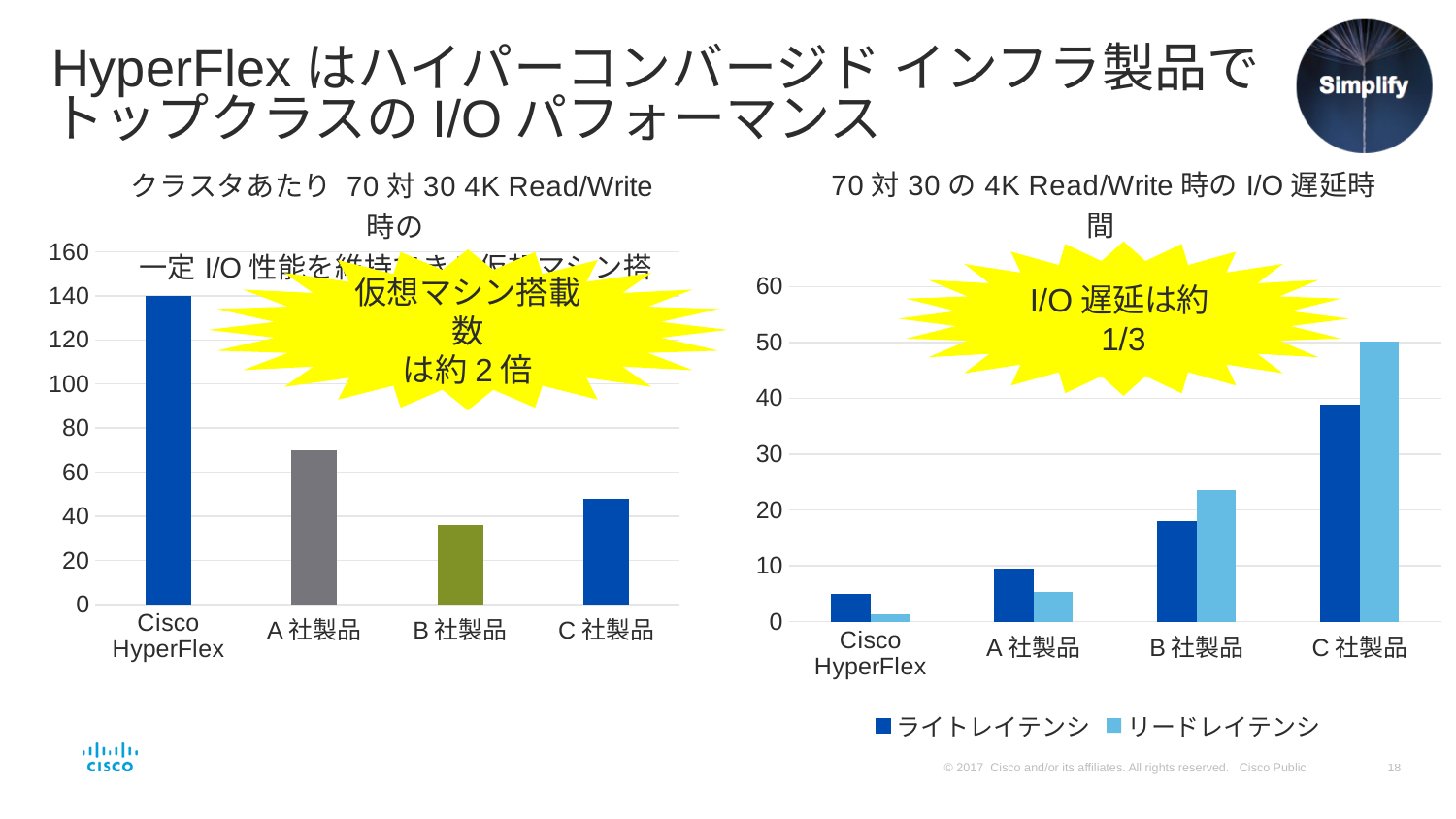
How many series does the legend of the right chart list? 2 In the right chart, which series is shown in light blue? リードレイテンシ In the right chart, which category has the highest リードレイテンシ value? C 社製品 In the left chart, is the value for Cisco HyperFlex greater or less than 120? greater In the right chart, is the ライトレイテンシ value for C 社製品 greater or less than 30? greater In the left chart, is the value for A 社製品 greater or less than 60? greater How many categories are shown on the x axis of the left chart? 4 In the left chart, which is larger, the value for A 社製品 or the value for C 社製品? A 社製品 In the right chart, which category has the lowest ライトレイテンシ value? Cisco HyperFlex What kind of chart is the left chart on the slide? bar chart In the left chart, which category has the lowest bar? B 社製品 In the left chart, which category has the highest bar? Cisco HyperFlex